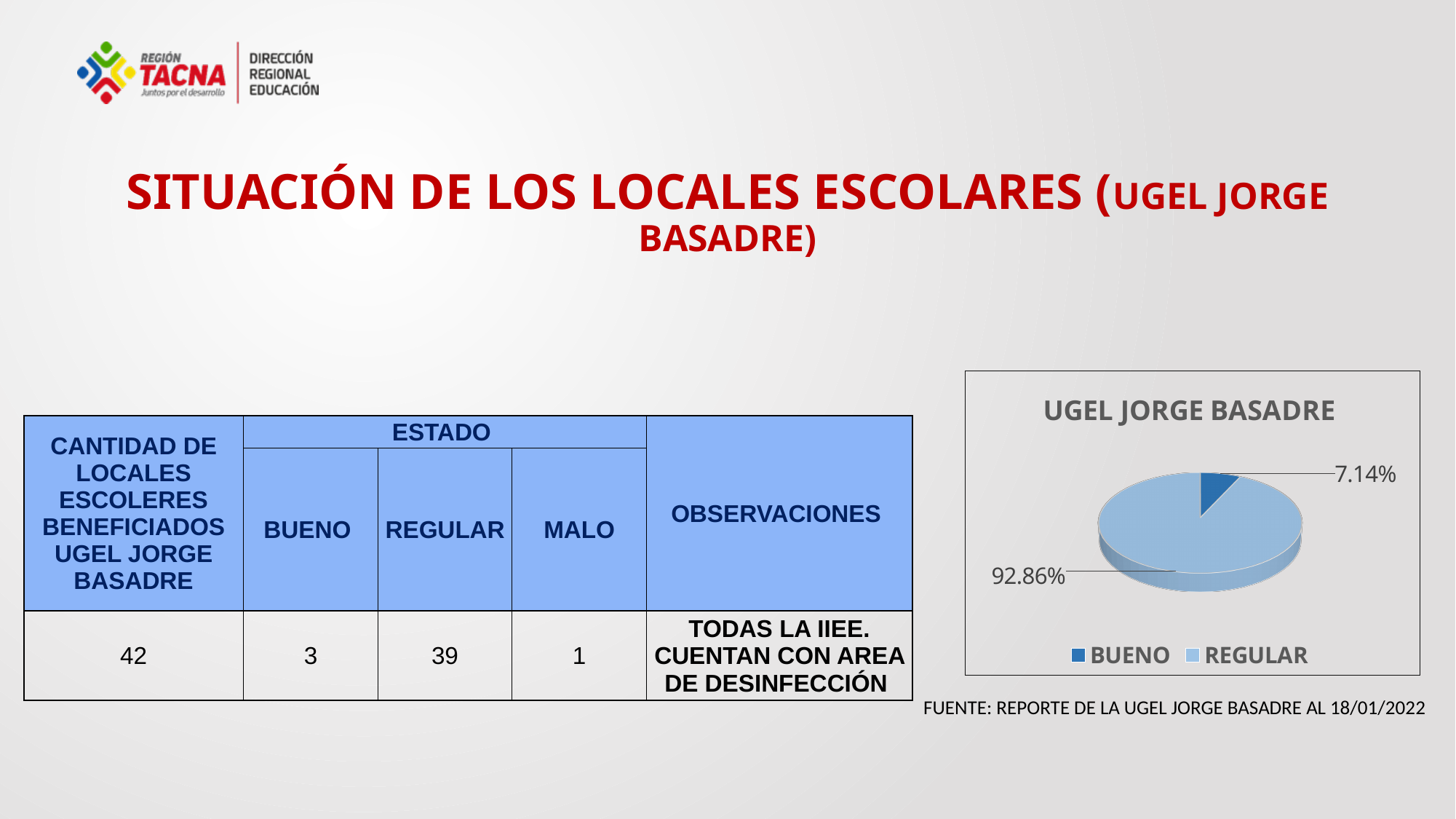
What share of the pie does BUENO represent? 7.14% How many slices does the pie chart have? 2 Which is larger, the share for BUENO or the share for REGULAR? REGULAR Which slice of the pie is the largest? REGULAR What is the title of the chart? UGEL JORGE BASADRE Which slice of the pie is the smallest? BUENO How many entries does the chart legend list? 2 Which legend entry is shown in the darker blue colour? BUENO What is the difference in percentage points between the REGULAR and BUENO shares? 85.72 What share of the pie does REGULAR represent? 92.86% What type of chart is shown on the slide? pie chart